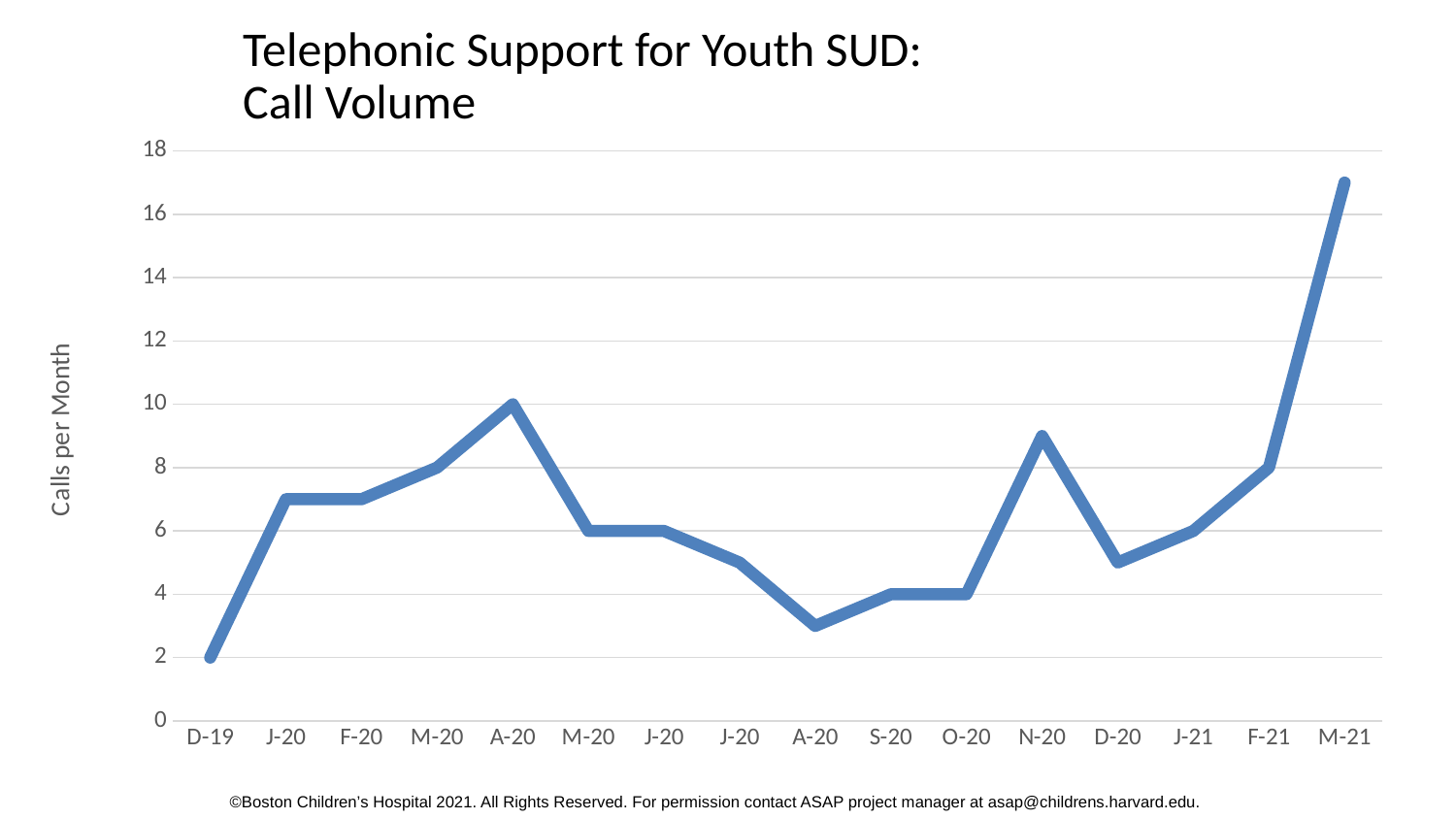
Is the value for M-21 greater or less than 16? greater What is the call volume for J-21? 6 What is the call volume for D-19? 2 Which month has the lowest call volume? D-19 Which month has the highest call volume? M-21 How many months are plotted on the x axis? 16 What is the label on the vertical axis? Calls per Month Which is larger, the call volume for F-21 or for J-21? F-21 What is the call volume for S-20? 4 What is the call volume for F-21? 8 What kind of chart is shown on the slide? line chart Is the value for N-20 greater or less than 8? greater